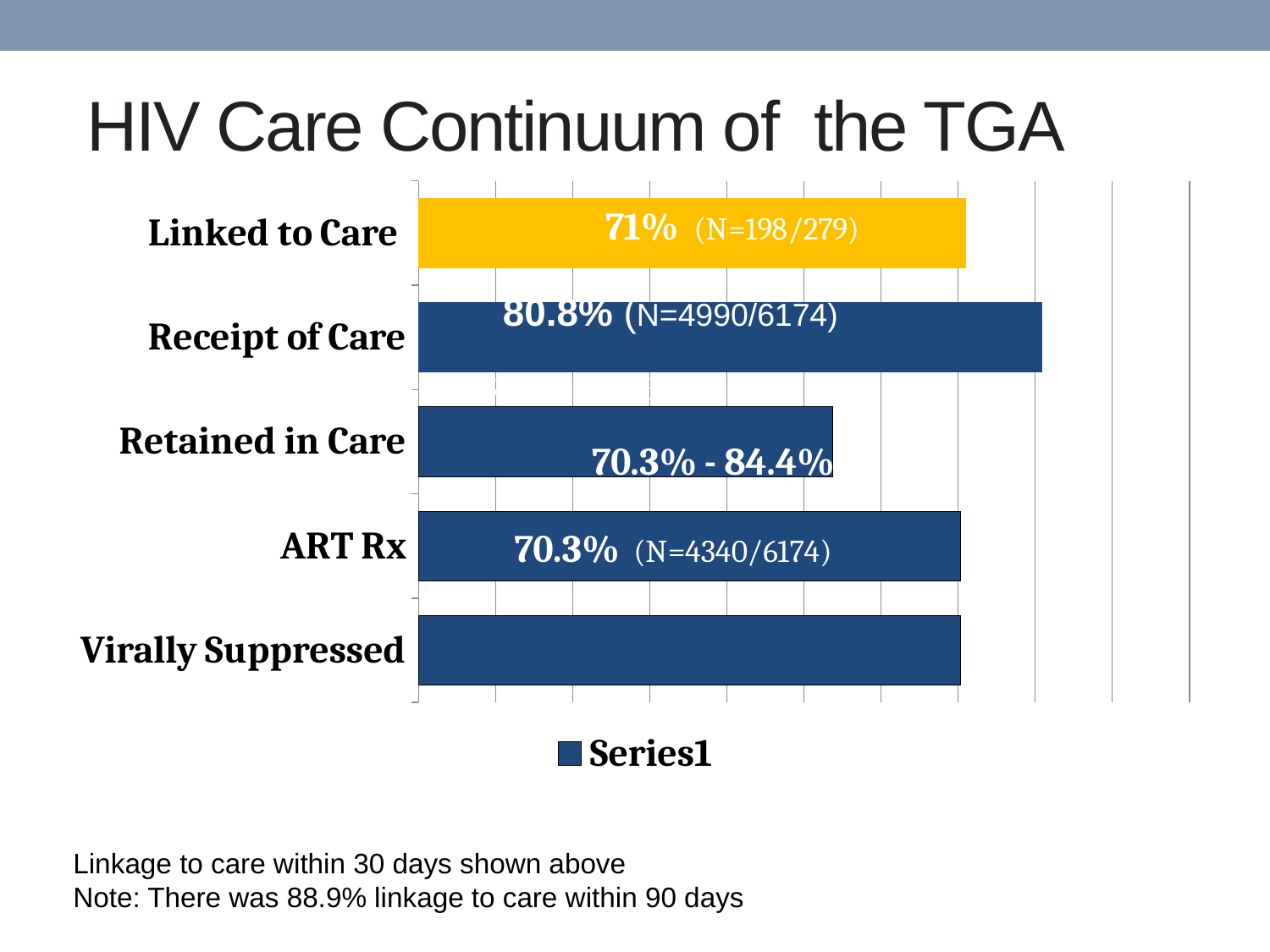
What type of chart is shown on the slide? Bar chart What percentage is shown for Receipt of Care? 80.8% What N value is shown for ART Rx? N=4340/6174 Which category has the shortest bar? Retained in Care What range is shown for Retained in Care? 70.3% - 84.4% What is the difference in percentage points between Receipt of Care and Linked to Care? 9.8 How many categories are shown on the chart? 5 Which category has the longest bar? Receipt of Care What is the title of the chart on the slide? HIV Care Continuum of the TGA What percentage is shown for Linked to Care? 71% What percentage is shown for ART Rx? 70.3% How many series does the legend list? 1